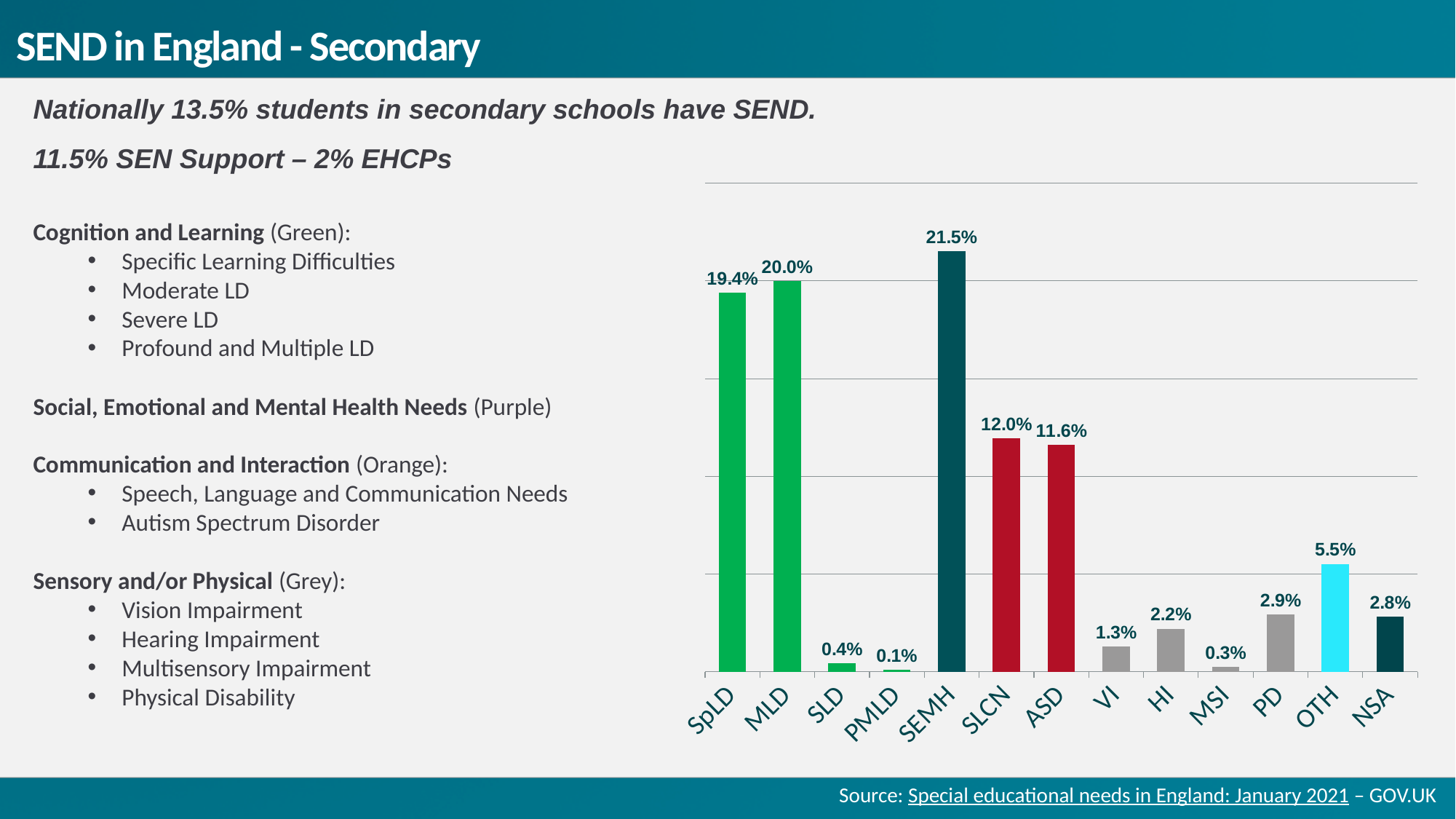
Which is larger, the value for HI or the value for VI? HI Which is larger, the value for PD or the value for NSA? PD Which category has the lowest value? PMLD Which category has the highest value? SEMH What kind of chart is shown on the slide? Bar chart What is the value for OTH? 5.5% What is the value for SpLD? 19.4% What is the difference between the values for SLCN and ASD? 0.4% How many categories are shown on the x axis of the chart? 13 What is the value for MSI? 0.3% What is the difference between the values for MLD and SpLD? 0.6% What is the value for SEMH? 21.5%